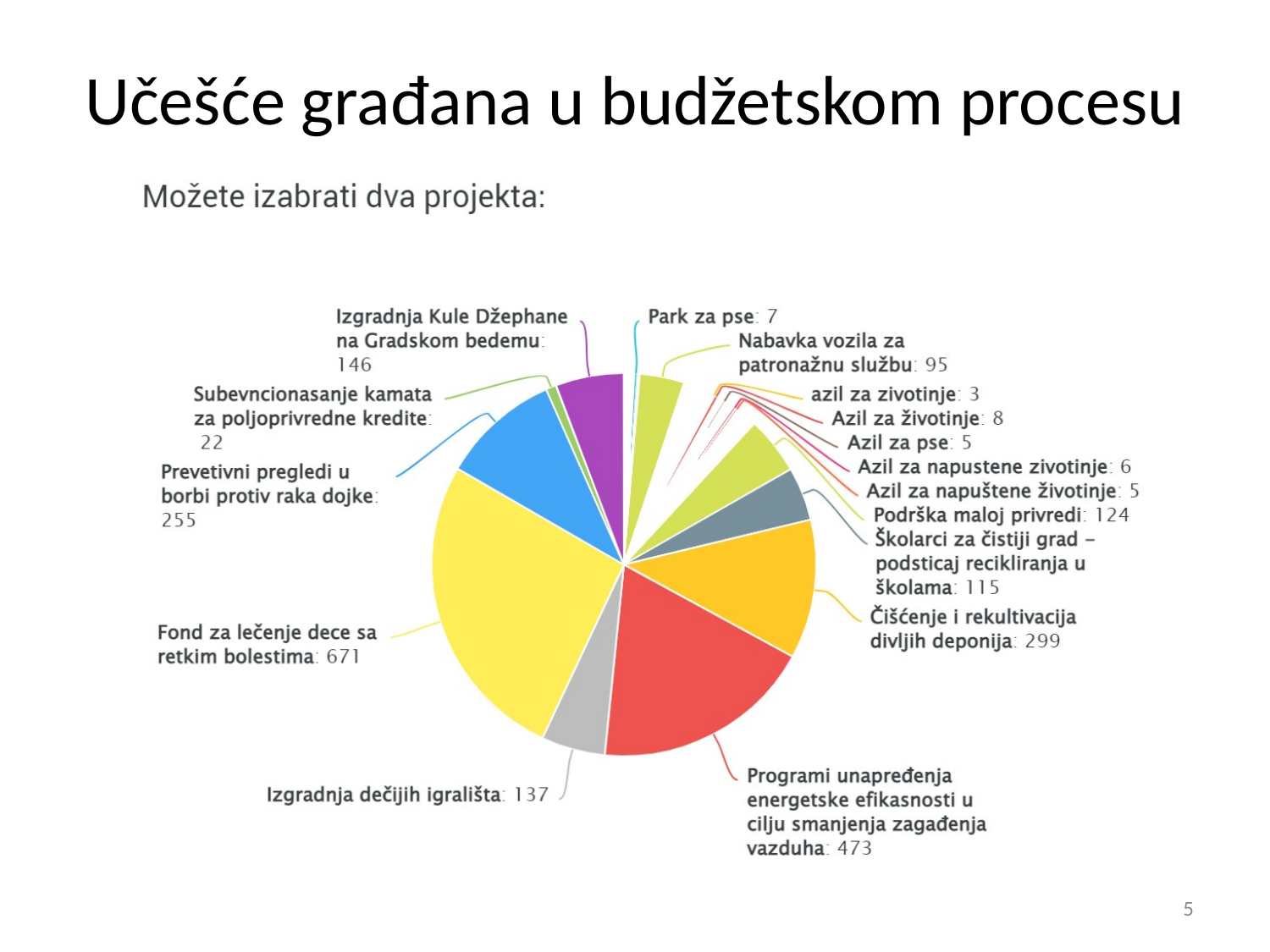
What kind of chart is shown on the slide? pie chart What is the difference between the values for Fond za lečenje dece sa retkim bolestima and Programi unapređenja energetske efikasnosti u cilju smanjenja zagađenja vazduha? 198 What is the value for Nabavka vozila za patronažnu službu? 95 Which category has the largest slice of the pie? Fond za lečenje dece sa retkim bolestima What is the value for Programi unapređenja energetske efikasnosti u cilju smanjenja zagađenja vazduha? 473 Which category has the smallest value in the pie chart? azil za zivotinje (3) What is the value for Čišćenje i rekultivacija divljih deponija? 299 What is the title of the slide containing the pie chart? Učešće građana u budžetskom procesu What is the value for Izgradnja dečijih igrališta? 137 Which is larger: Podrška maloj privredi or Školarci za čistiji grad – podsticaj recikliranja u školama? Podrška maloj privredi How many categories are shown in the pie chart? 16 What is the value for Fond za lečenje dece sa retkim bolestima? 671